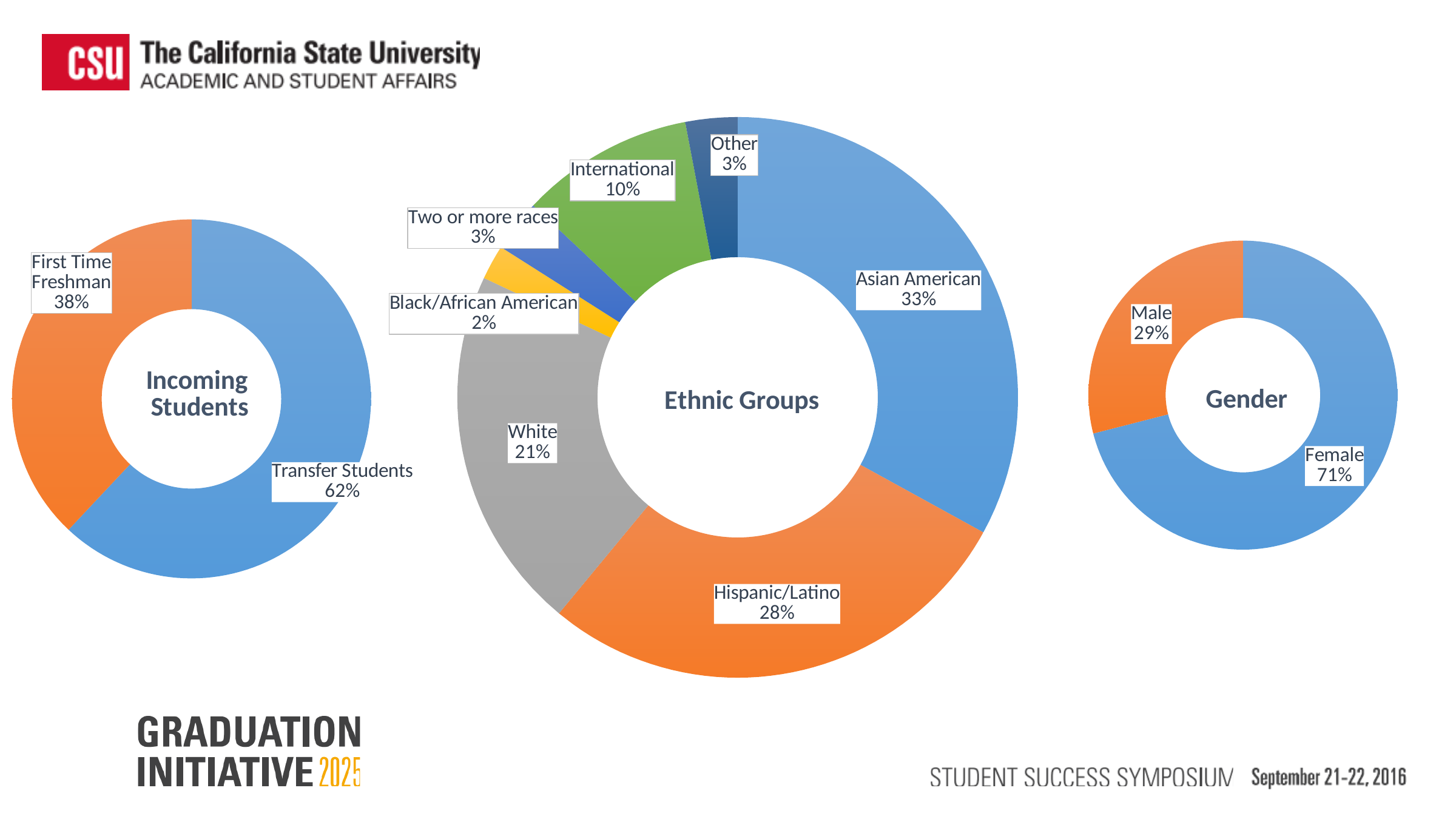
In the Ethnic Groups chart, how many groups are shown? 7 What kind of chart is the Gender chart? Doughnut (pie) chart In the Ethnic Groups chart, which group has the largest share? Asian American In the Incoming Students chart, what share is First Time Freshman? 38% In the Gender chart, what is the difference between the Female and Male shares? 42 percentage points In the Gender chart, what share is Male? 29% In the Ethnic Groups chart, which group has the smallest share? Black/African American In the Ethnic Groups chart, what is the difference between the Asian American and White shares? 12 percentage points In the Incoming Students chart, what share is Transfer Students? 62% In the Ethnic Groups chart, what share is International? 10% In the Ethnic Groups chart, what share is Hispanic/Latino? 28% In the Gender chart, which is larger, Female or Male? Female